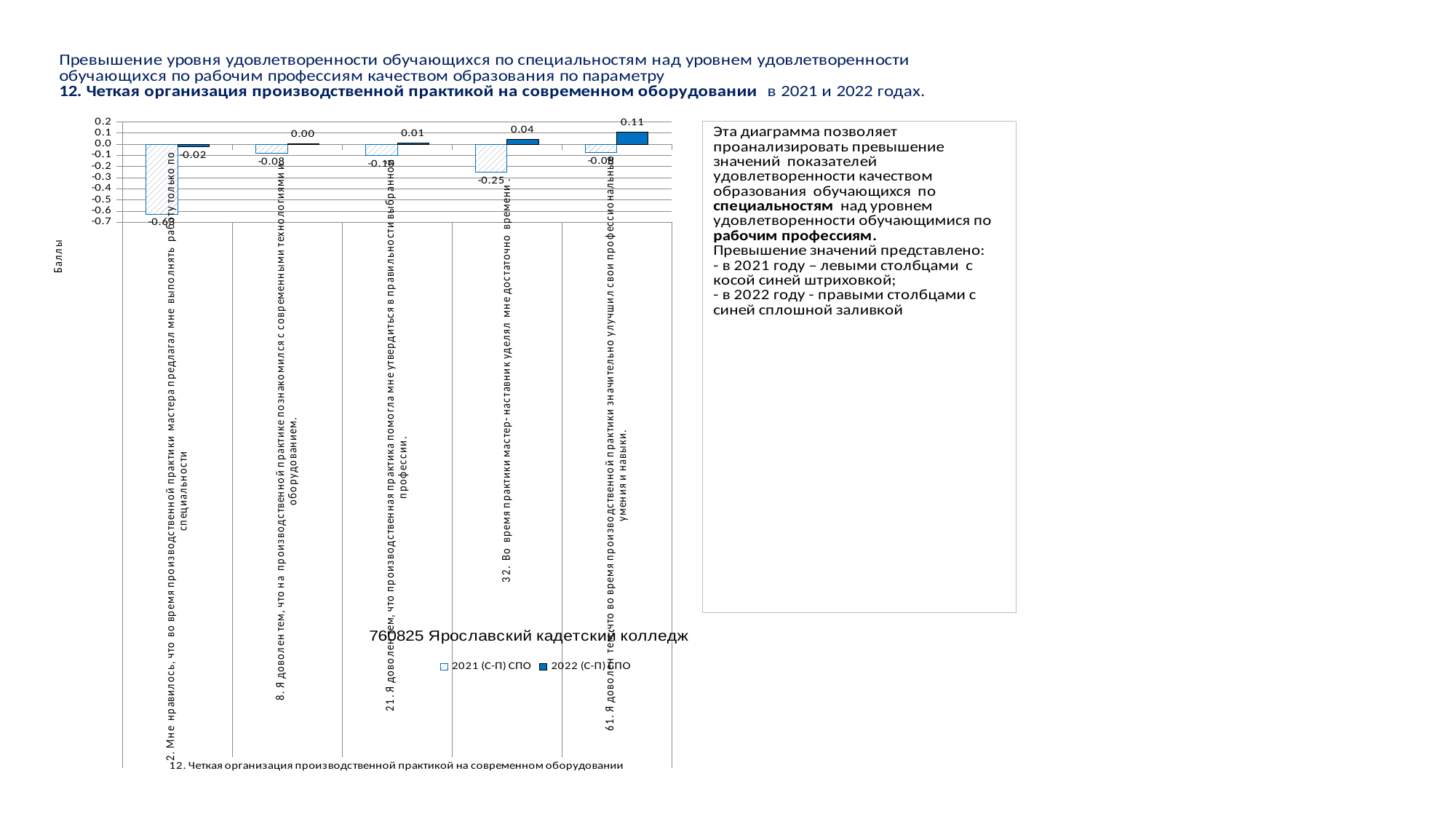
What is the 2021 (С-П) СПО value for category 8 (Я доволен тем, что на производственной практике познакомился с современными технологиями и оборудованием)? -0.08 What kind of chart is shown on the slide? bar chart Which category has the highest 2022 (С-П) СПО value? 61 Which category has the lowest 2021 (С-П) СПО value? 2 What is the 2021 (С-П) СПО value for category 32? -0.25 How many series does the legend list? 2 What is the 2022 (С-П) СПО value for category 32 (Во время практики мастер-наставник уделял мне достаточно времени)? 0.04 What is the 2022 (С-П) СПО value for category 2 (Мне нравилось, что во время производственной практики мастера предлагал мне выполнять работу только по специальности)? -0.02 How many categories (questions) are plotted on the x axis? 5 For category 32, what is the difference between the 2022 value and the 2021 value? 0.29 What is the 2022 (С-П) СПО value for category 61 (Я доволен тем, что во время производственной практики значительно улучшил свои профессиональные умения и навыки)? 0.11 Is the 2021 (С-П) СПО value for category 2 greater or less than -0.5? less